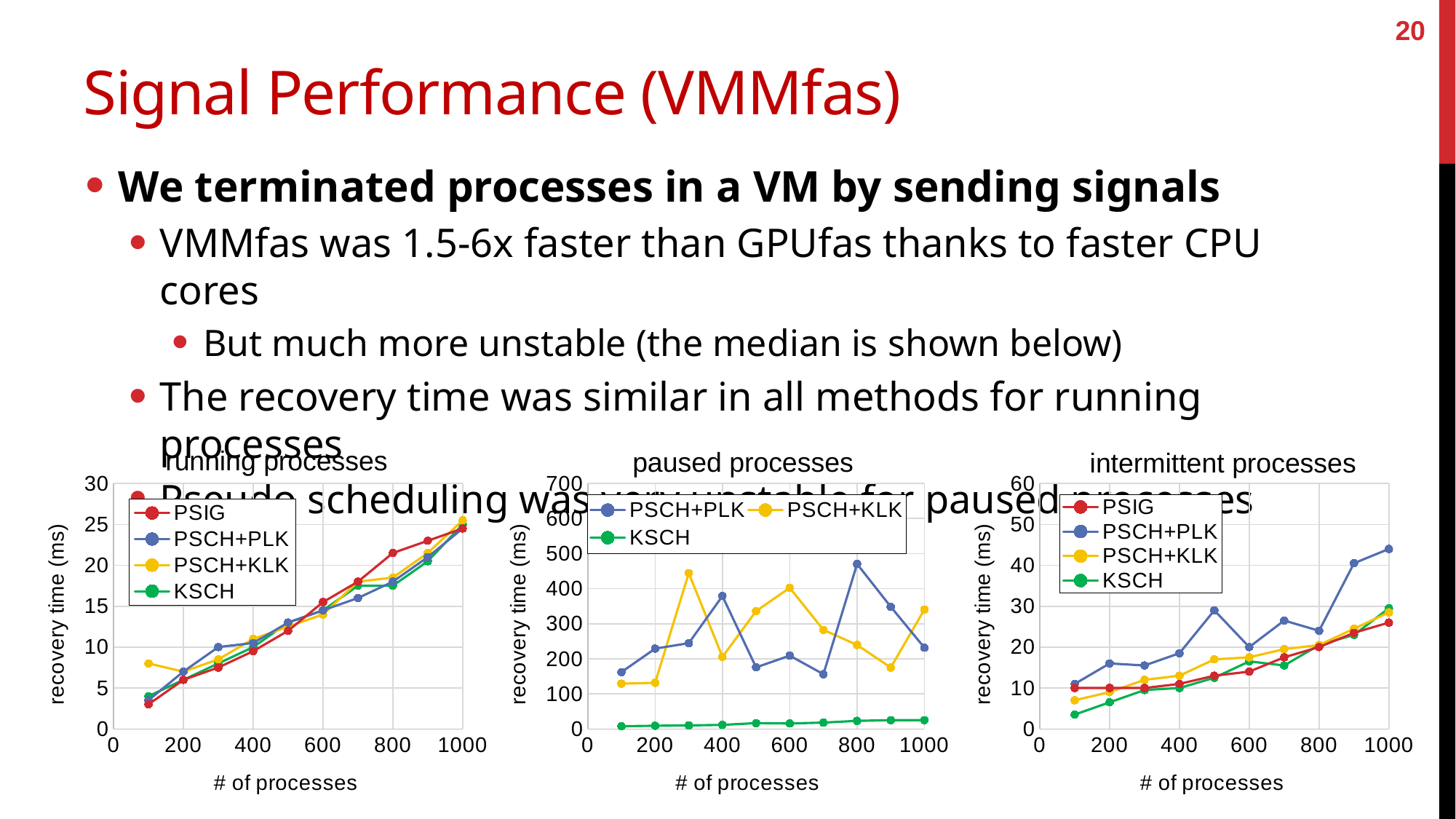
In the "paused processes" chart, is the value for PSCH+KLK at 300 processes greater or less than 400? greater How many series does the legend of the "paused processes" chart list? 3 In the "paused processes" chart, is the value for KSCH at 1000 processes greater or less than 100? less How many series does the legend of the "intermittent processes" chart list? 4 In the "running processes" chart, how many data points does the PSIG series have? 10 In the "paused processes" chart, which series has the lowest recovery time across all process counts? KSCH In the "intermittent processes" chart, at 500 processes, which is larger: PSCH+PLK or PSIG? PSCH+PLK In the "running processes" chart, is the value for PSCH+KLK at 100 processes greater or less than 5? greater In the "intermittent processes" chart, which series has the highest recovery time at 1000 processes? PSCH+PLK In the "running processes" chart, does the recovery time for KSCH rise or fall as the number of processes increases? rise What kind of chart is the "running processes" chart? line chart How many charts are shown on the slide? 3